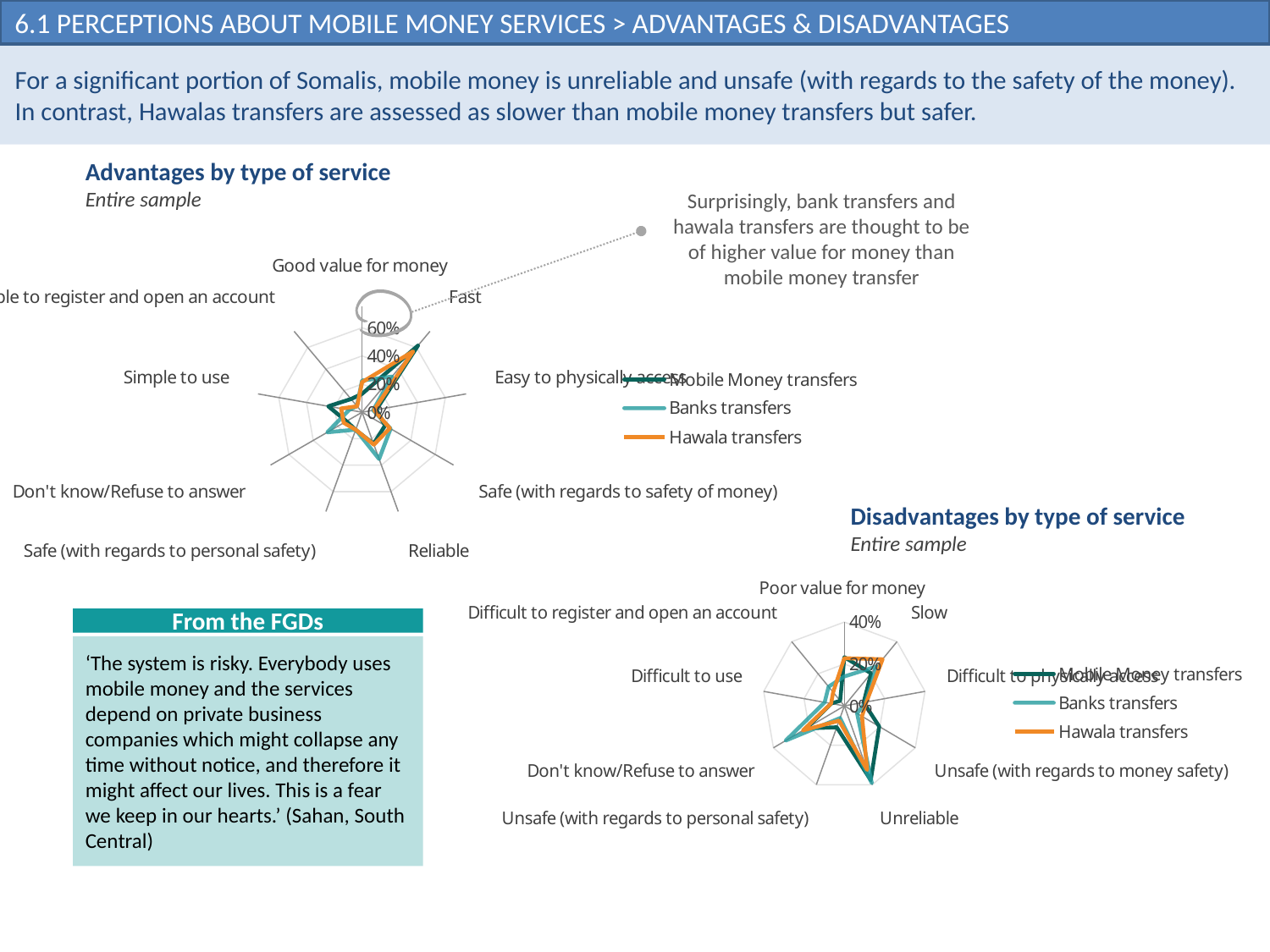
How many categories (axes) does the 'Disadvantages by type of service' chart have? 9 What kind of chart is the 'Advantages by type of service' chart? Radar chart In the 'Disadvantages by type of service' chart, is the value for Mobile Money transfers on 'Unreliable' greater or less than 20%? greater What is the highest percentage tick shown on the 'Disadvantages by type of service' chart? 40% In the 'Disadvantages by type of service' chart, which is larger for 'Unreliable': Mobile Money transfers or Hawala transfers? Mobile Money transfers In the 'Advantages by type of service' chart, is the value for Mobile Money transfers on 'Fast' greater or less than 40%? greater In the 'Disadvantages by type of service' chart, which is larger for 'Slow': Hawala transfers or Mobile Money transfers? Hawala transfers What kind of chart is the 'Disadvantages by type of service' chart? Radar chart How many series does the legend of the 'Advantages by type of service' chart list? 3 In the 'Advantages by type of service' chart, which is larger for 'Fast': Mobile Money transfers or Hawala transfers? Mobile Money transfers In the 'Advantages by type of service' chart, which series is shown in orange? Hawala transfers In the 'Disadvantages by type of service' chart, is the value for Banks transfers on 'Poor value for money' greater or less than 40%? less